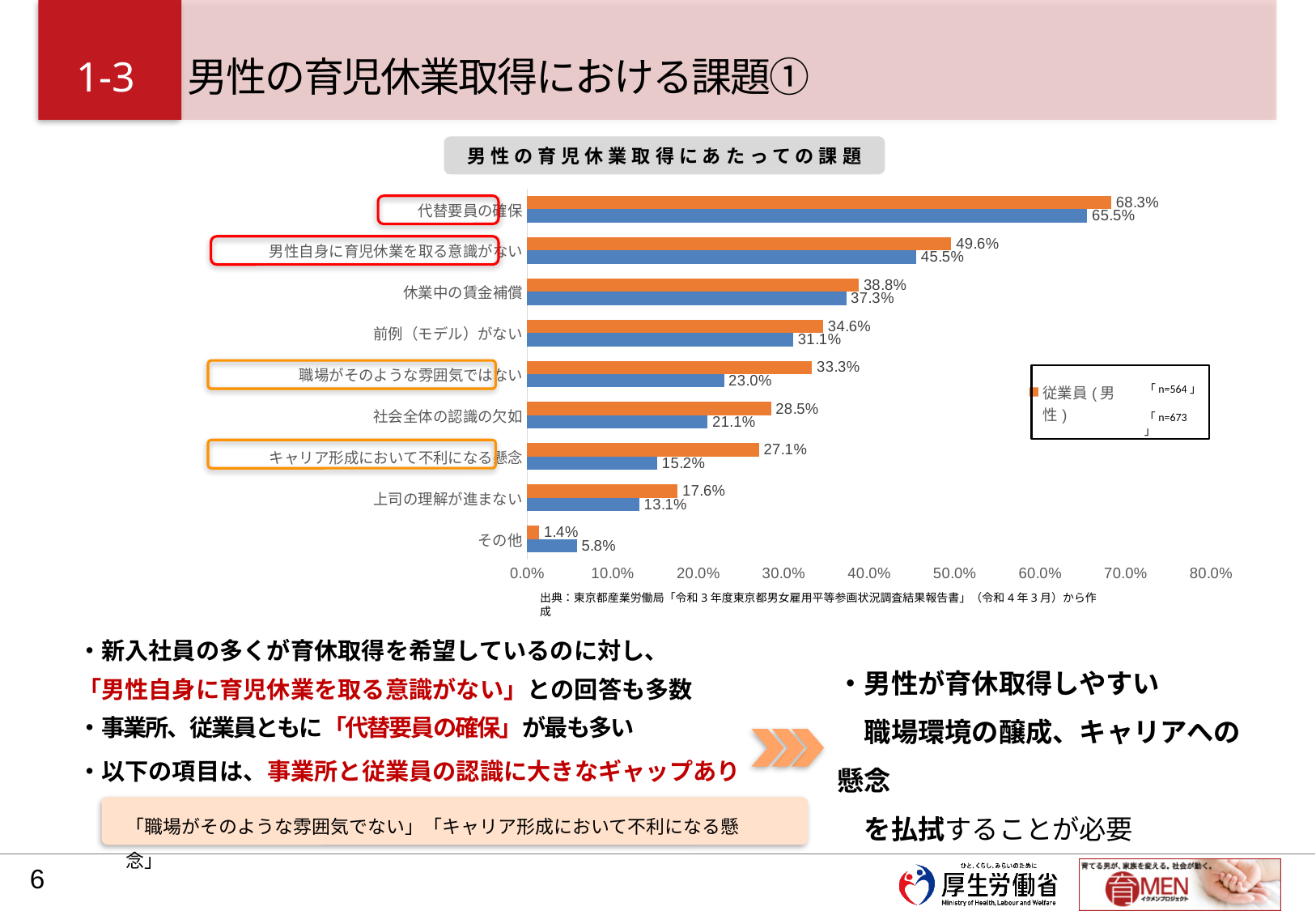
For その他, which bar is larger, the orange one or the blue one? the blue one What is the difference between the orange and blue bars for 職場がそのような雰囲気ではない? 10.3% Which category has the highest value for the orange series (従業員(男性))? 代替要員の確保 Is the blue bar for 休業中の賃金補償 greater or less than 40.0%? less Which category has the lowest value for the blue series? その他 What is the title shown above the chart? 男性の育児休業取得にあたっての課題 What is the value of the blue bar for 男性自身に育児休業を取る意識がない? 45.5% What is the value of the orange bar (従業員(男性)) for 代替要員の確保? 68.3% What is the value of the orange bar (従業員(男性)) for キャリア形成において不利になる懸念? 27.1% What type of chart is shown on the slide? bar chart How many categories are plotted in the chart? 9